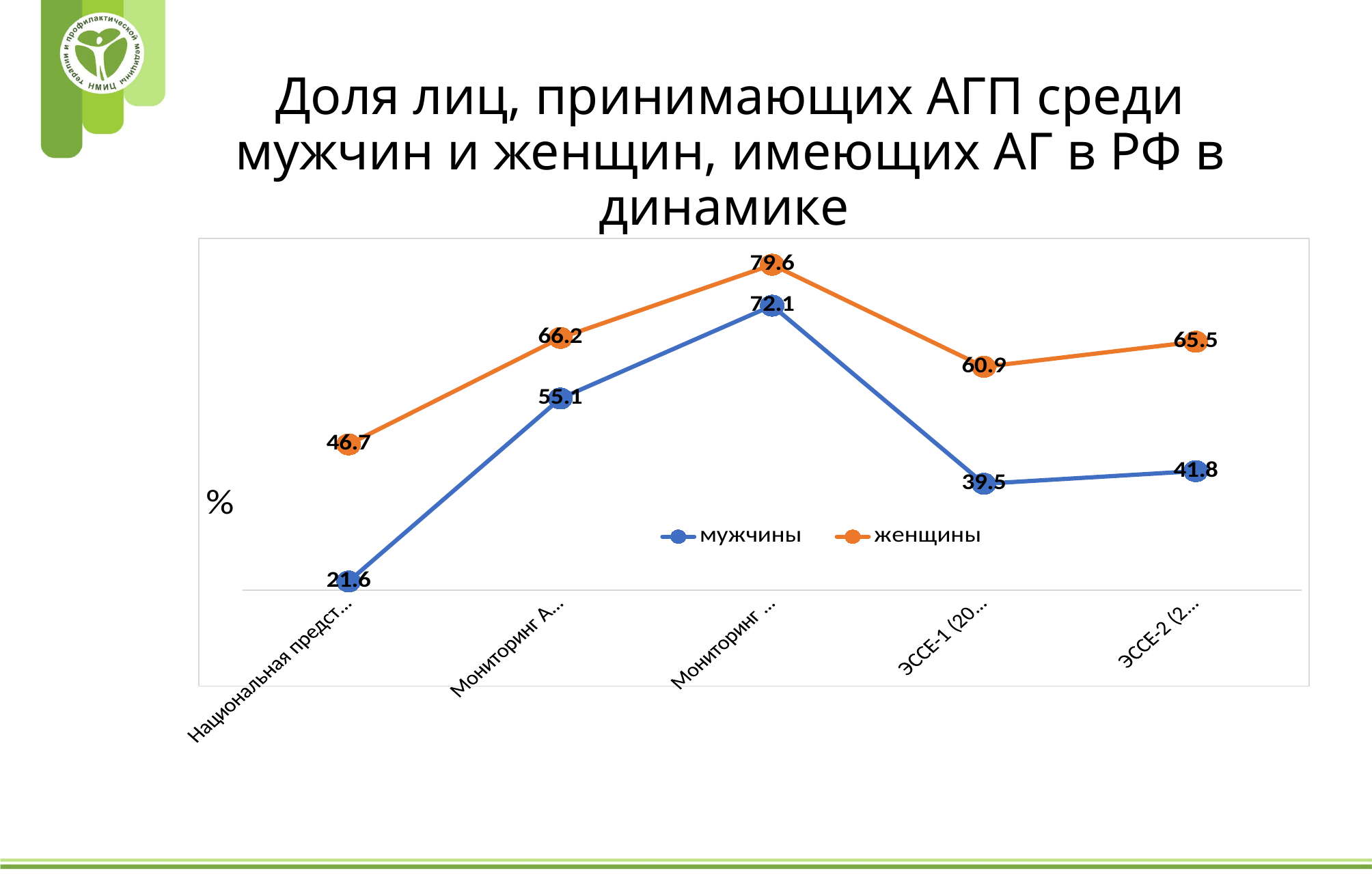
What is the highest value plotted for женщины? 79.6 What is the value for мужчины at the first category on the x axis? 21.6 What is the difference between the женщины values at ЭССЕ-2 and ЭССЕ-1? 4.6 For мужчины, which is larger: the value at ЭССЕ-1 or at ЭССЕ-2? ЭССЕ-2 How many series does the legend list? 2 Does the value for женщины rise or fall from the third category to ЭССЕ-1? fall At ЭССЕ-2, how much higher is the value for женщины than for мужчины? 23.7 What is the lowest value plotted for мужчины? 21.6 What is the value for женщины at ЭССЕ-2? 65.5 What is the value for мужчины at ЭССЕ-1? 39.5 What kind of chart is shown on the slide? line chart How many categories are shown on the x axis? 5